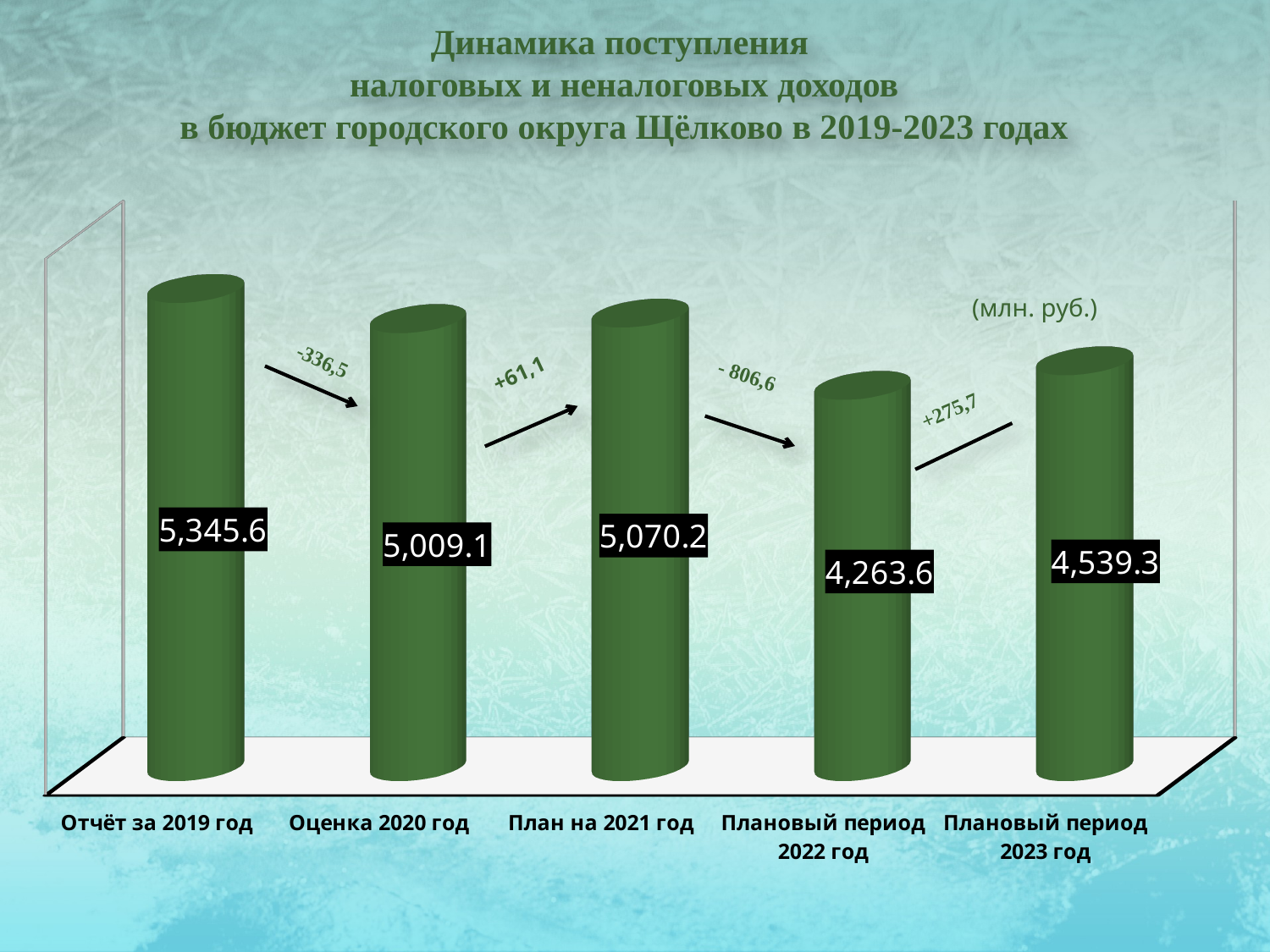
What is the difference between the values for "Плановый период 2023 год" and "Плановый период 2022 год"? 275.7 What is the value for "План на 2021 год"? 5,070.2 What is the value for "Плановый период 2023 год"? 4,539.3 What is the value for "Отчёт за 2019 год"? 5,345.6 What is the value for "Плановый период 2022 год"? 4,263.6 How many categories are shown on the chart? 5 Which is larger, the value for "План на 2021 год" or the value for "Оценка 2020 год"? План на 2021 год What is the difference between the values for "Отчёт за 2019 год" and "Оценка 2020 год"? 336.5 What kind of chart is shown on the slide? Bar chart What is the value for "Оценка 2020 год"? 5,009.1 Which category has the highest value? Отчёт за 2019 год Which category has the lowest value? Плановый период 2022 год